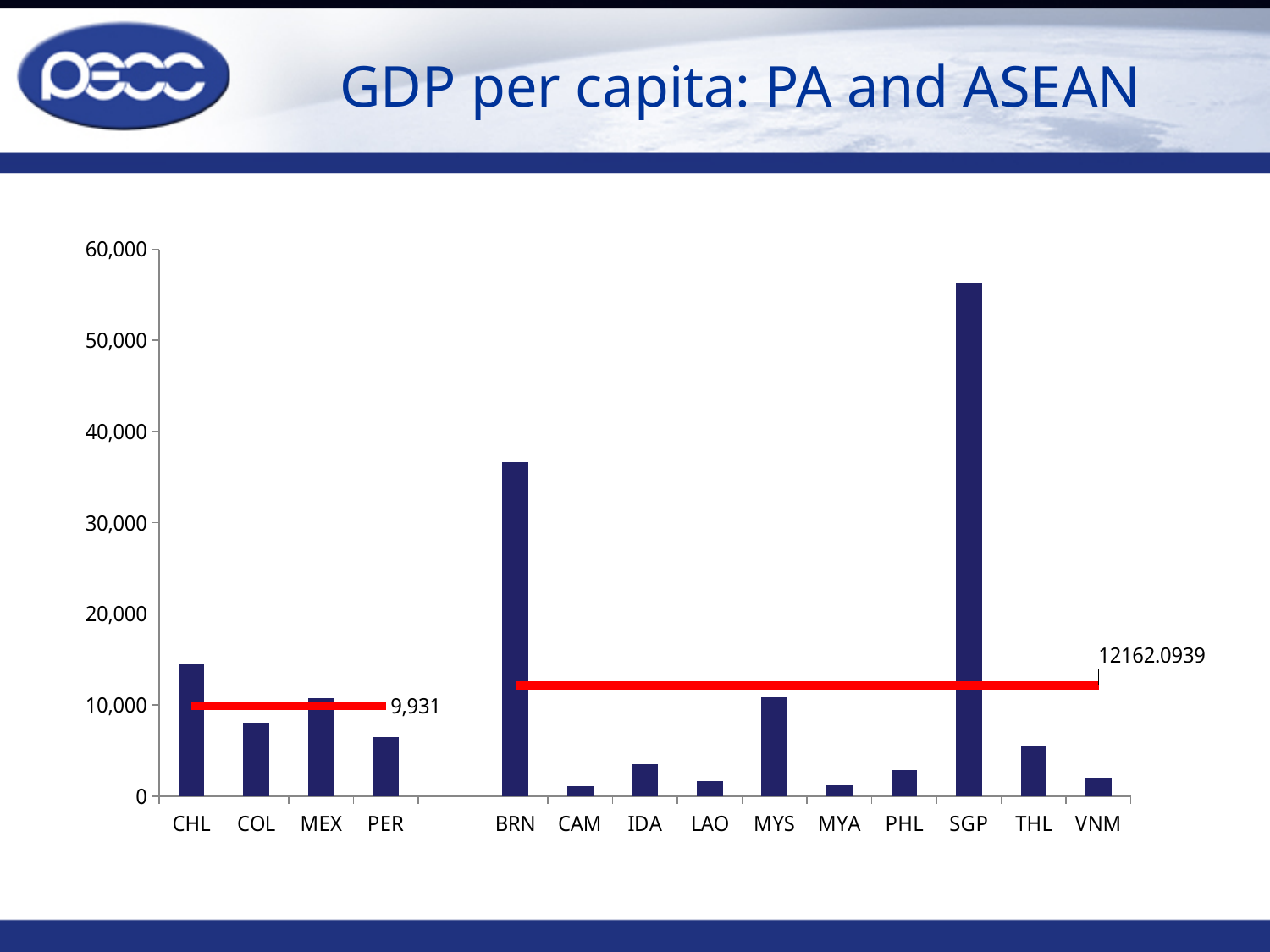
Which economy has the highest GDP per capita in the chart? SGP How many economies (categories) are labelled on the x axis of the chart? 14 What is the title of the chart on the slide? GDP per capita: PA and ASEAN Is the value for BRN greater or less than 30,000? greater Which has the larger GDP per capita, IDA or VNM? IDA What value is printed next to the red line spanning the PA economies (CHL to PER)? 9,931 Is the value for CHL greater or less than 10,000? greater What value is printed next to the red line spanning the ASEAN economies (BRN to VNM)? 12162.0939 Is the value for COL greater or less than 10,000? less Which has the larger GDP per capita, BRN or SGP? SGP What kind of chart is shown on the slide? bar chart